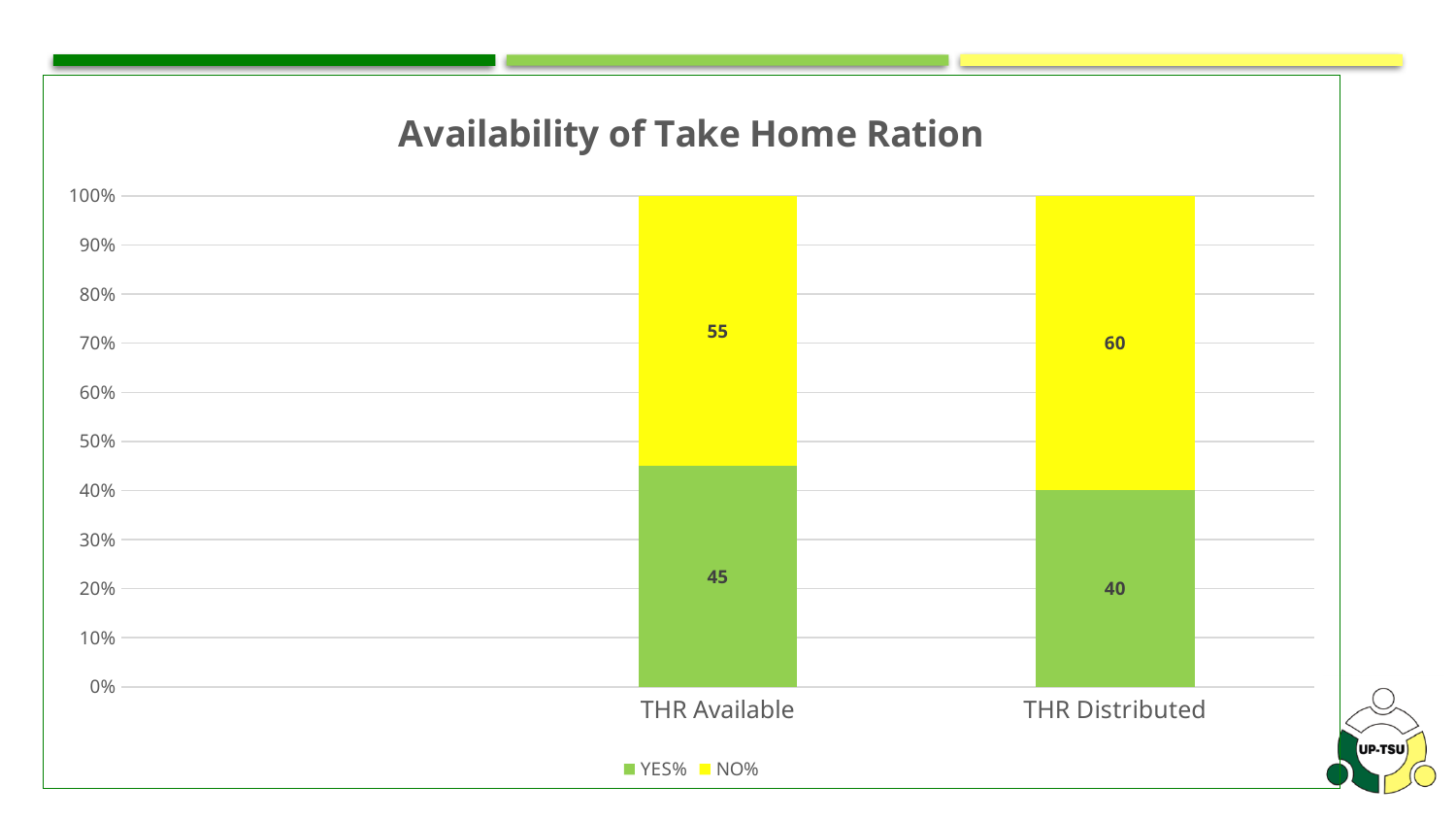
How many categories are shown on the x axis? 2 What is the NO% value for THR Available? 55 What is the YES% value for THR Available? 45 Which category has the higher YES% value? THR Available Which category has the lower NO% value? THR Available What is the title of the chart? Availability of Take Home Ration What is the difference between the NO% values for THR Distributed and THR Available? 5 What is the YES% value for THR Distributed? 40 What kind of chart is shown? stacked bar chart What is the NO% value for THR Distributed? 60 How many series does the legend list? 2 Is the NO% value for THR Available larger or smaller than the YES% value for THR Available? larger